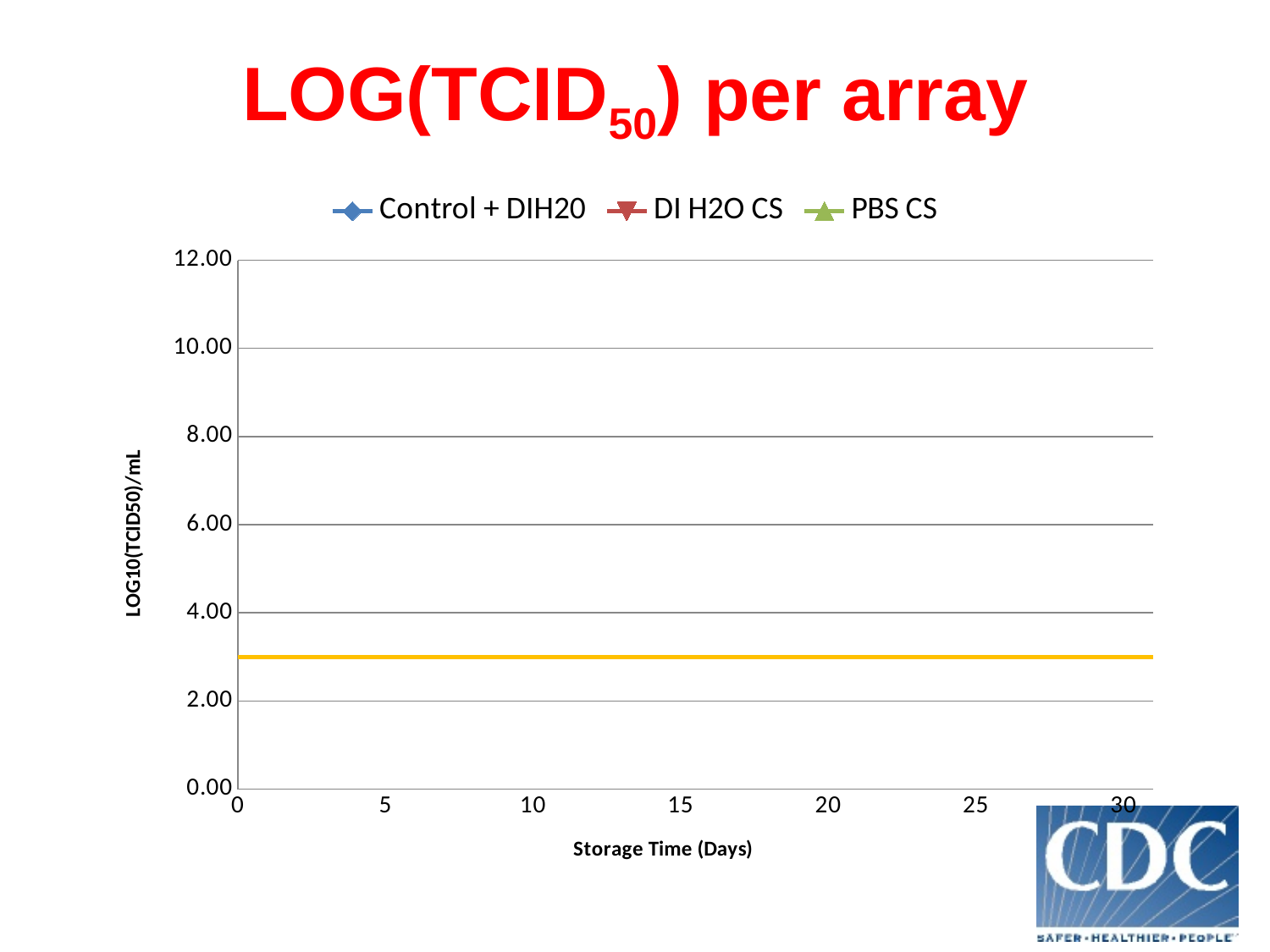
Is the yellow horizontal line on the chart greater or less than 4.00? less What is the title of the chart on the slide? LOG(TCID50) per array What is the label of the x axis? Storage Time (Days) What kind of chart is shown on the slide? line chart Is the yellow horizontal line on the chart greater or less than 2.00? greater Does the yellow horizontal line rise, fall, or stay flat across the x axis? stays flat How many series does the legend list? 3